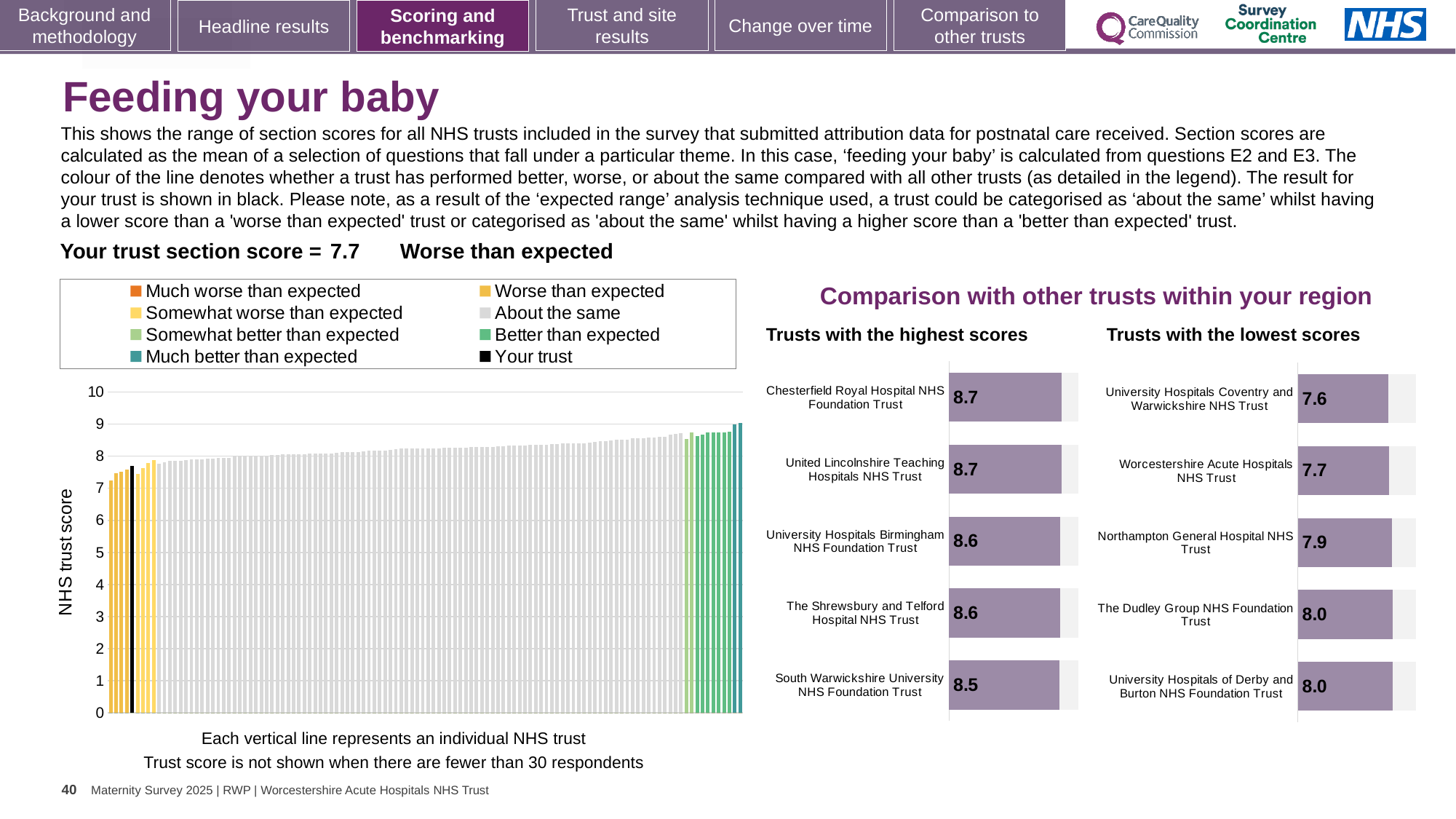
How many entries does the legend of the large 'NHS trust score' chart list? 8 In the 'Trusts with the highest scores' chart, what is the difference between the scores of Chesterfield Royal Hospital NHS Foundation Trust and South Warwickshire University NHS Foundation Trust? 0.2 What kind of chart is the large chart on the left with the 'NHS trust score' axis? bar chart In the 'Trusts with the lowest scores' chart, which has the higher score: Northampton General Hospital NHS Trust or Worcestershire Acute Hospitals NHS Trust? Northampton General Hospital NHS Trust In the 'Trusts with the highest scores' chart, which trust has the lowest score shown? South Warwickshire University NHS Foundation Trust In the 'Trusts with the lowest scores' chart, which trust has the lowest score? University Hospitals Coventry and Warwickshire NHS Trust How many trusts are listed in the 'Trusts with the highest scores' chart? 5 In the 'Trusts with the lowest scores' chart, what is the score for Worcestershire Acute Hospitals NHS Trust? 7.7 In the large 'NHS trust score' chart on the left, do the bar values rise or fall from left to right? rise In the 'Trusts with the lowest scores' chart, what is the difference between the scores of The Dudley Group NHS Foundation Trust and University Hospitals Coventry and Warwickshire NHS Trust? 0.4 In the 'Trusts with the highest scores' chart, what is the score for Chesterfield Royal Hospital NHS Foundation Trust? 8.7 In the large 'NHS trust score' chart on the left, is the value for the black 'Your trust' bar greater or less than 8? less